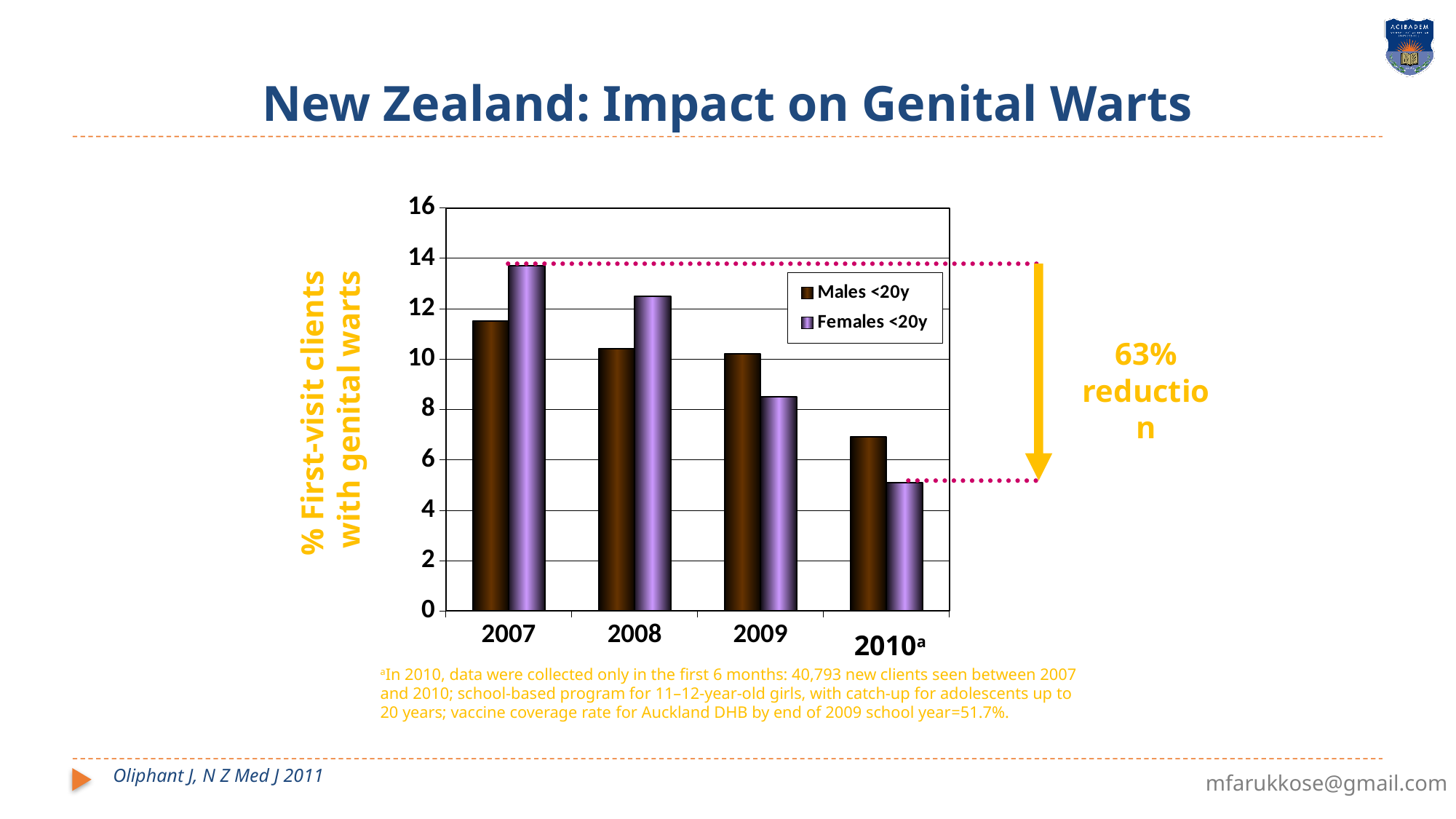
Is the value for Females <20y in 2009 greater or less than 10? less Which year has the highest value for Females <20y? 2007 Which year has the lowest value for Females <20y? 2010 What kind of chart is shown on the slide? bar chart Is the value for Males <20y in 2010 greater or less than 8? less In 2009, which is larger: Males <20y or Females <20y? Males <20y How many series does the legend list? 2 Do the values for Females <20y rise or fall from 2007 to 2010? fall Is the value for Females <20y in 2007 greater or less than 12? greater How many years are shown on the x axis? 4 Which year has the lowest value for Males <20y? 2010 What percentage reduction is annotated next to the chart? 63% reduction